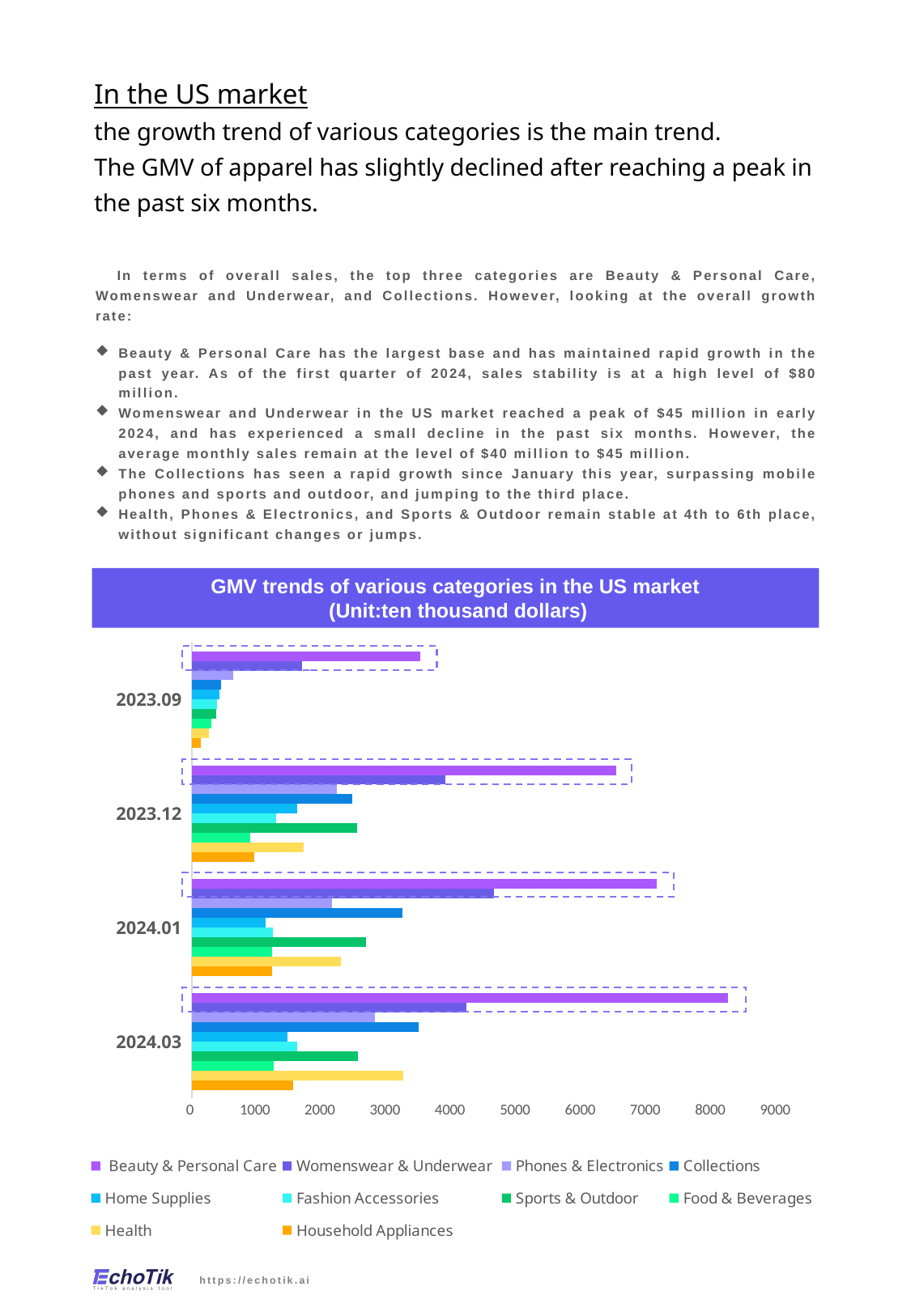
Which is larger for Womenswear & Underwear: the value in 2024.01 or the value in 2024.03? 2024.01 What is the title of the chart? GMV trends of various categories in the US market (Unit:ten thousand dollars) Is the value for Household Appliances in 2023.09 greater or less than 1000? less In which period is the Beauty & Personal Care bar the longest? 2024.03 Is the value for Womenswear & Underwear in 2024.01 greater or less than 4000? greater How many series does the chart's legend list? 10 Is the value for Beauty & Personal Care in 2024.03 greater or less than 8000? greater How many time periods are shown on the chart's vertical axis? 4 What kind of chart is shown on the slide? bar chart Which series is listed first in the chart's legend? Beauty & Personal Care In which period is the Beauty & Personal Care bar the shortest? 2023.09